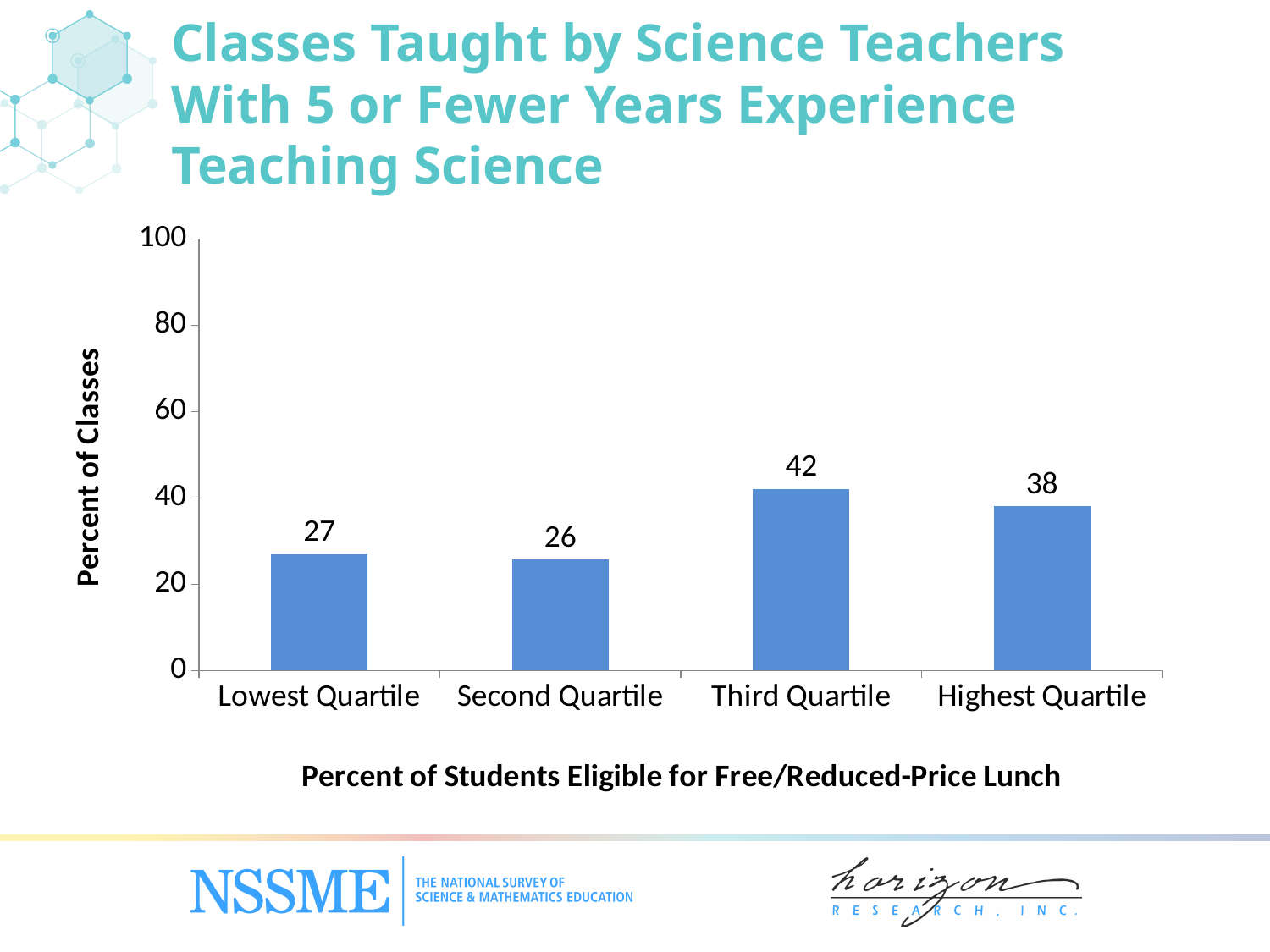
What is the value for Lowest Quartile? 27 Which quartile has the lowest percent of classes? Second Quartile What is the value for Third Quartile? 42 What is the value for Second Quartile? 26 What is the label of the y axis? Percent of Classes Which quartile has the highest percent of classes? Third Quartile How many categories are shown on the x axis? 4 Is the value for Third Quartile greater or less than 40? greater Which is larger, the value for Lowest Quartile or the value for Highest Quartile? Highest Quartile What is the difference between the values for Third Quartile and Highest Quartile? 4 What is the value for Highest Quartile? 38 What kind of chart is shown on the slide? bar chart